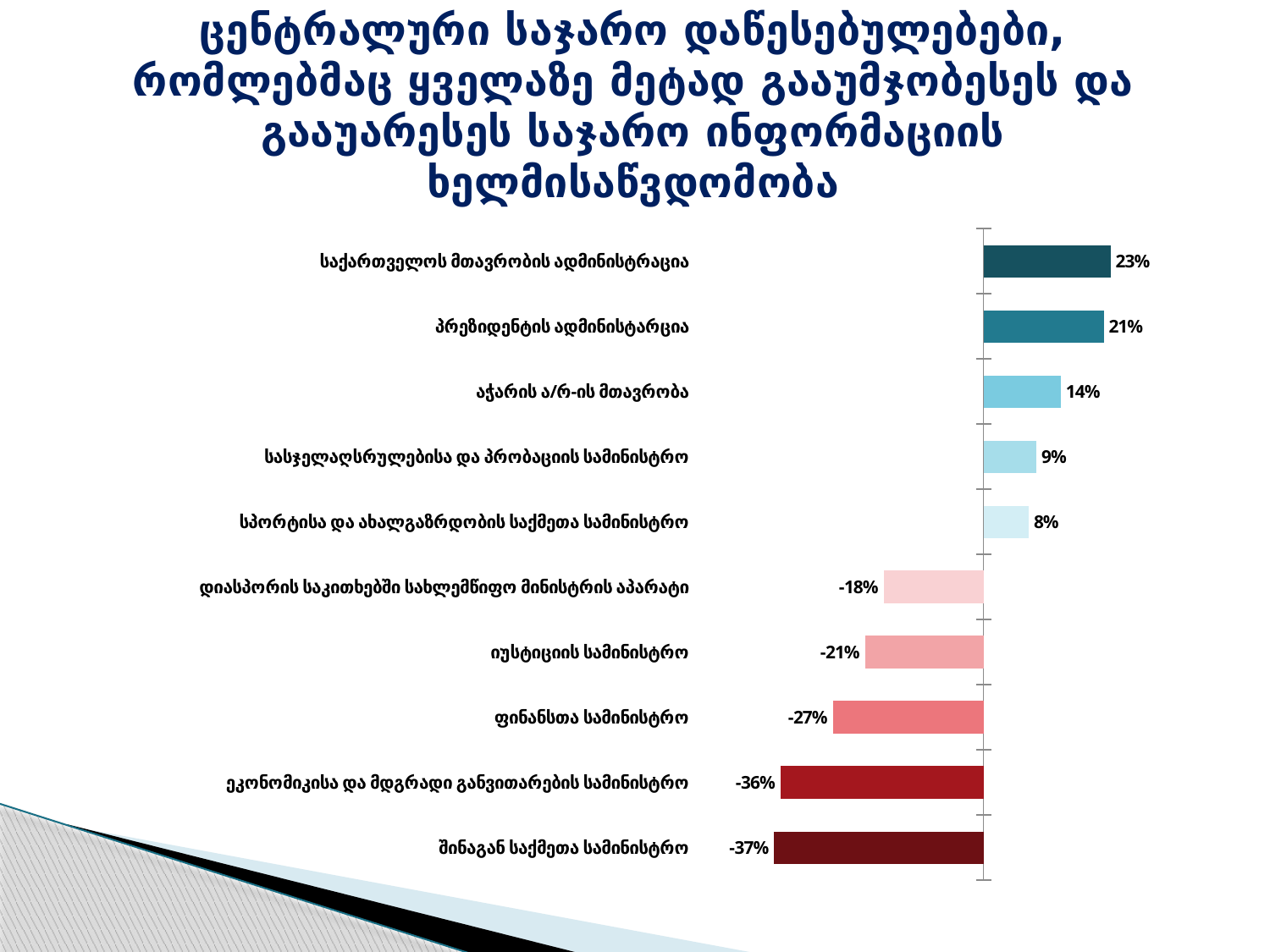
Which is larger in absolute terms: the value for სასჯელაღსრულებისა და პრობაციის სამინისტრო or სპორტისა და ახალგაზრდობის საქმეთა სამინისტრო? სასჯელაღსრულებისა და პრობაციის სამინისტრო What is the difference between the values for საქართველოს მთავრობის ადმინისტრაცია and პრეზიდენტის ადმინისტარცია? 2% What is the value for საქართველოს მთავრობის ადმინისტრაცია? 23% What colour are the bars with negative values? red (shades of red/pink) Which category has the highest value? საქართველოს მთავრობის ადმინისტრაცია Which category has the lowest value? შინაგან საქმეთა სამინისტრო What kind of chart is shown on the slide? bar chart What is the value for აჭარის ა/რ-ის მთავრობა? 14% What is the value for იუსტიციის სამინისტრო? -21% How many categories have negative values? 5 What is the value for ფინანსთა სამინისტრო? -27% How many categories (institutions) are plotted in the chart? 10